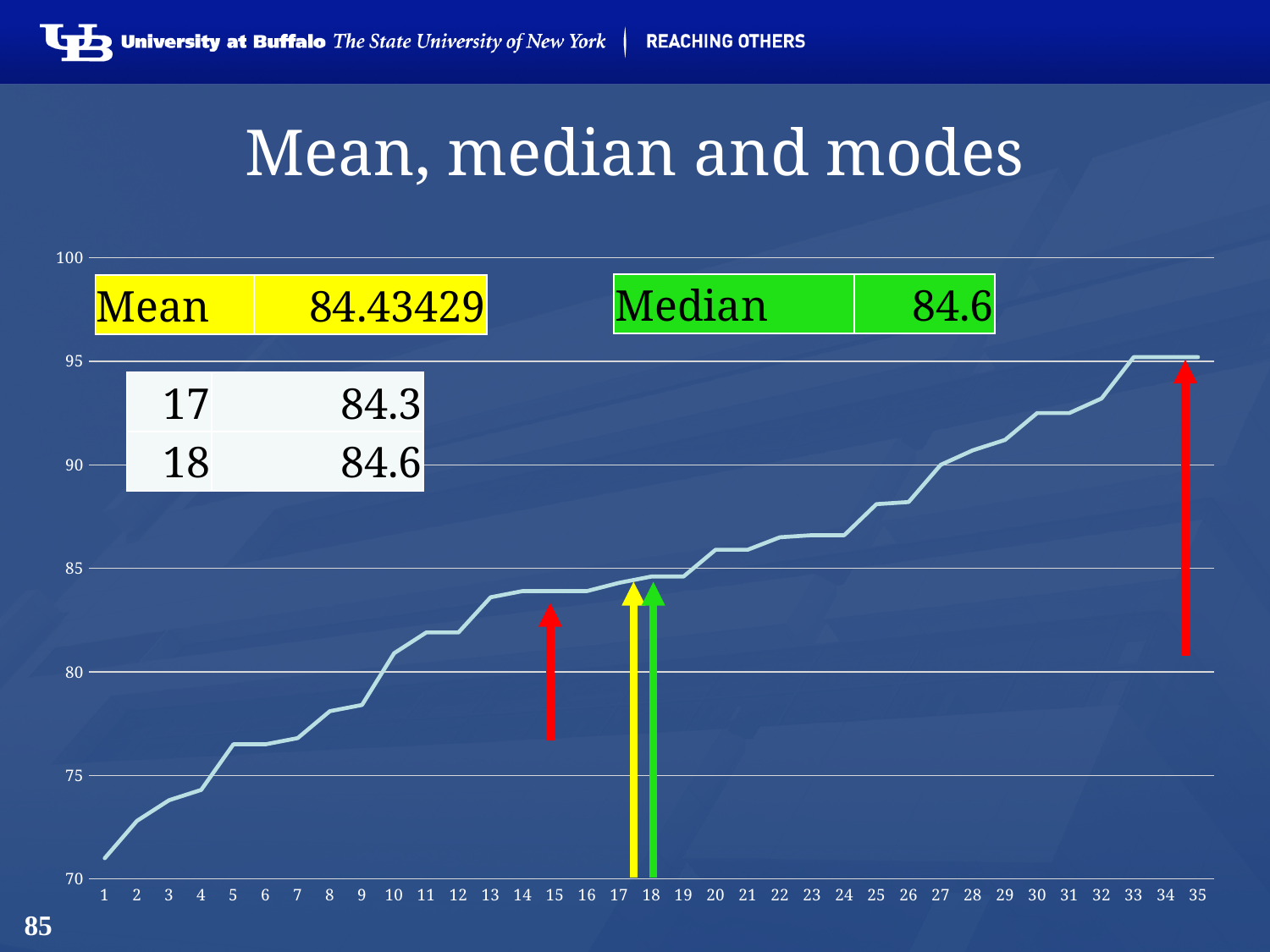
What value is listed for point 17 in the white table? 84.3 Which has the larger value, point 17 or point 18? 18 What is the mean value shown in the yellow box? 84.43429 What value is listed for point 18 in the white table? 84.6 Which point on the x axis has the lowest value? 1 How many data points are plotted along the x axis? 35 What kind of chart is shown on the slide? line chart Is the value for point 1 greater or less than 75? less What is the median value shown in the green box? 84.6 Do the values rise or fall as you move from point 1 to point 35 along the x axis? rise What is the difference between the values for points 18 and 17? 0.3 Is the value for point 33 greater or less than 90? greater